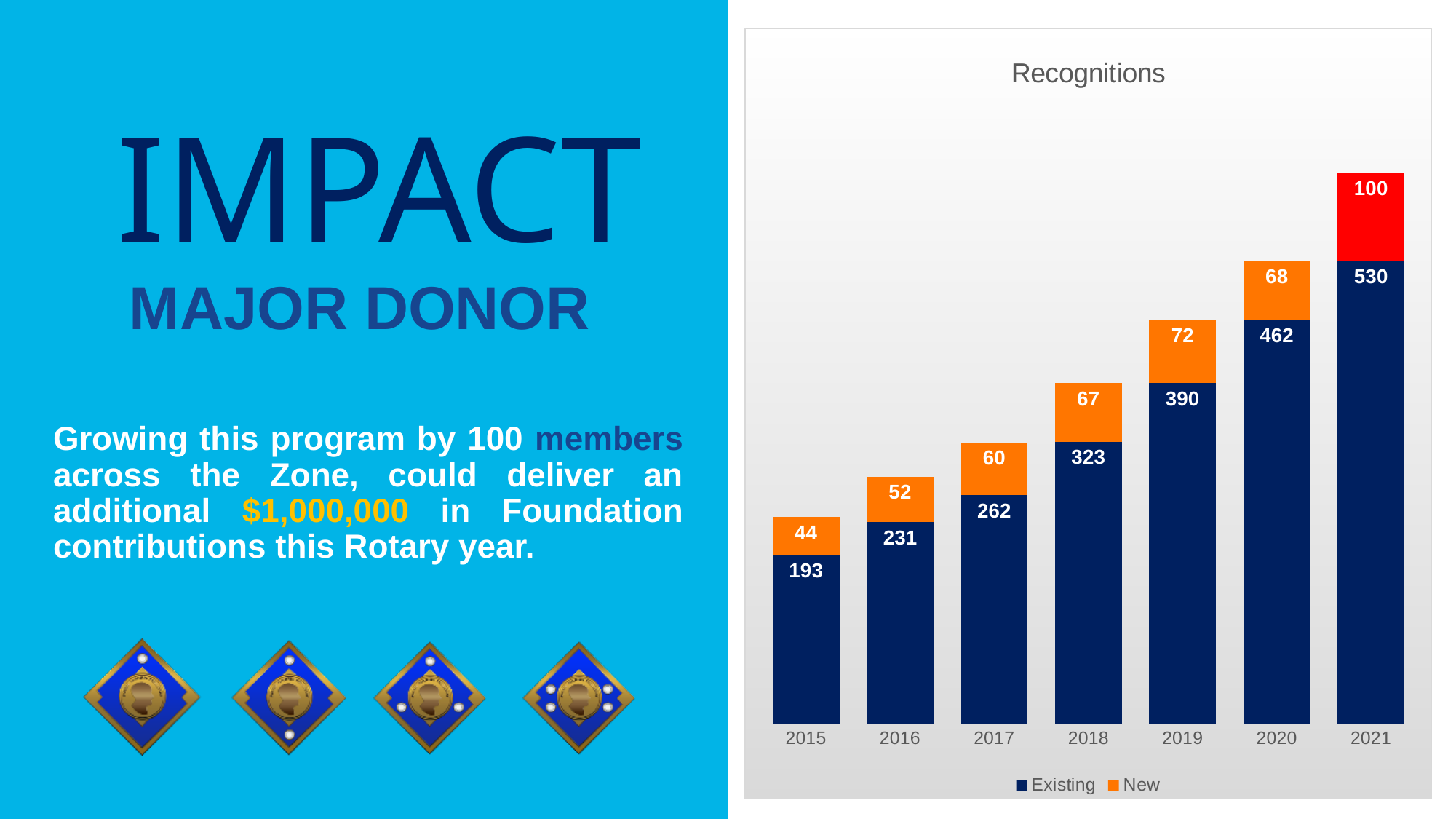
What is the New value for 2016 in the Recognitions chart? 52 What is the total of the stacked bar for 2021 in the Recognitions chart? 630 Which year has the lowest New value in the Recognitions chart? 2015 Is the New value for 2019 larger or smaller than the New value for 2020? larger What is the Existing value for 2018 in the Recognitions chart? 323 What is the difference between the Existing values for 2020 and 2019? 72 How many years are shown on the x axis of the Recognitions chart? 7 What is the title of the chart on the slide? Recognitions What kind of chart is the Recognitions chart? stacked bar chart How many series does the legend of the Recognitions chart list? 2 Do the Existing values rise or fall from 2015 to 2021? rise Which year has the highest Existing value in the Recognitions chart? 2021